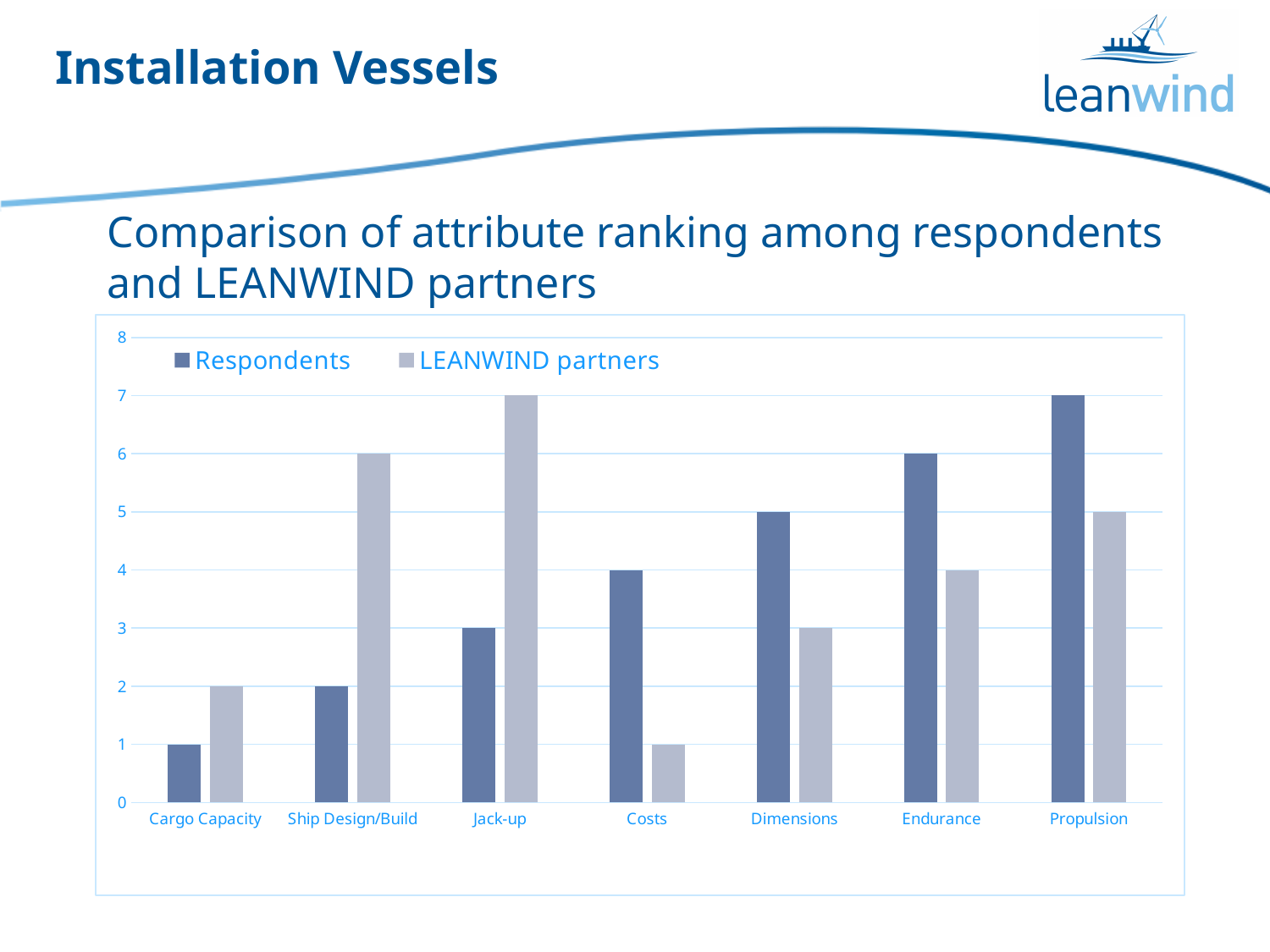
What is the LEANWIND partners value for Ship Design/Build? 6 What is the Respondents value for Propulsion? 7 Which category has the highest LEANWIND partners value? Jack-up Which category has the lowest LEANWIND partners value? Costs How many categories are shown on the x axis? 7 What is the difference between the Respondents and LEANWIND partners values for Ship Design/Build? 4 For Costs, which series has the larger value, Respondents or LEANWIND partners? Respondents What kind of chart is shown on the slide? Bar chart How many series does the legend list? 2 Which category has the lowest Respondents value? Cargo Capacity What is the LEANWIND partners value for Jack-up? 7 Do the Respondents values rise or fall from Cargo Capacity to Propulsion along the x axis? Rise